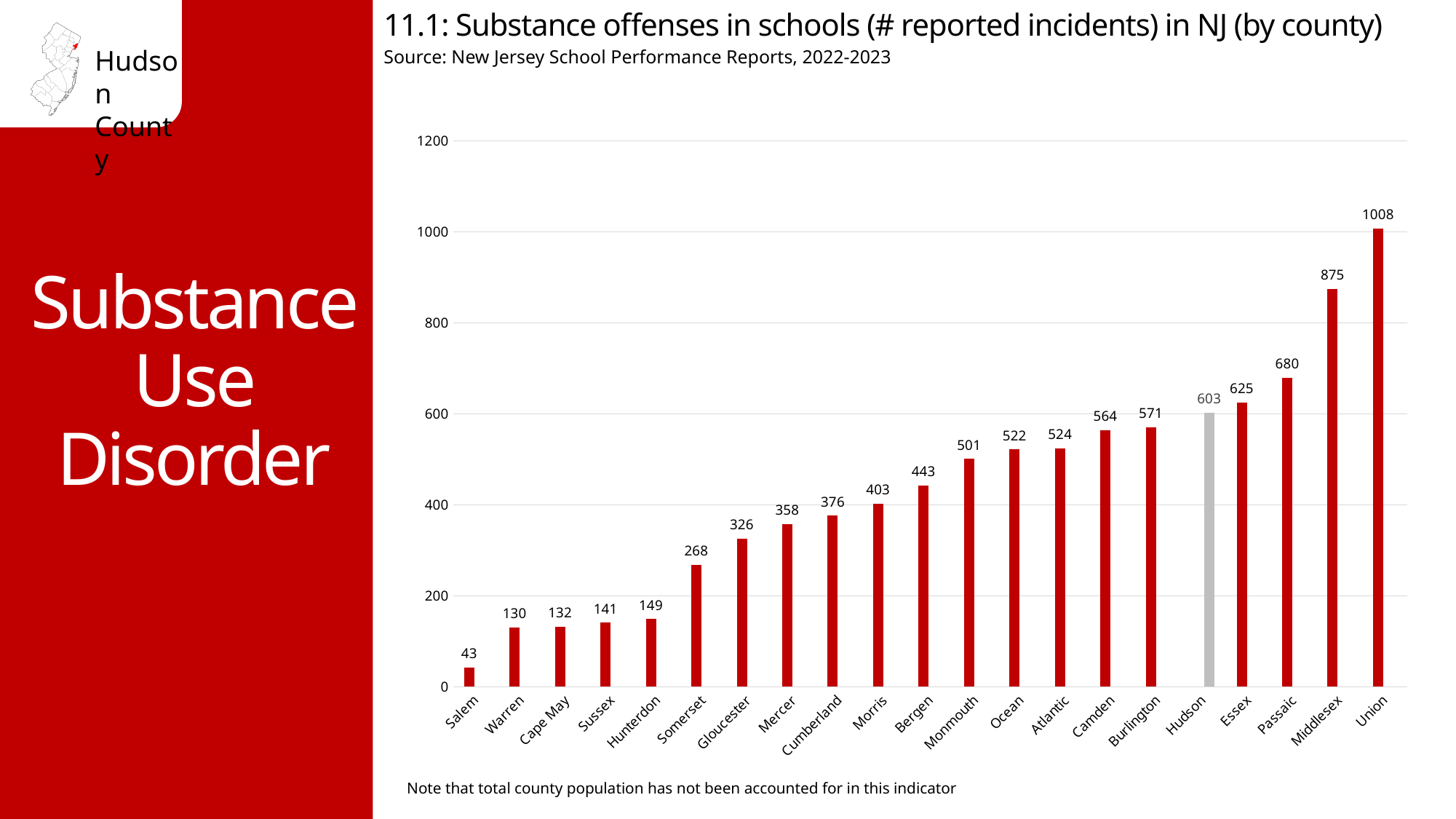
What is the value shown for Somerset? 268 What is the number of reported substance offense incidents in schools for Hudson County? 603 What kind of chart is shown on the slide? Bar chart Which county has the lowest number of reported incidents? Salem How many counties are shown on the x axis? 21 Which bar is shown in a different colour (grey) from the others? Hudson Is the value for Passaic greater or less than 600? greater What is the difference between the values for Union and Hudson? 405 Which county has the highest number of reported incidents? Union What is the value shown for Middlesex? 875 Which has a higher value, Bergen or Monmouth? Monmouth What is the difference between the values for Essex and Burlington? 54